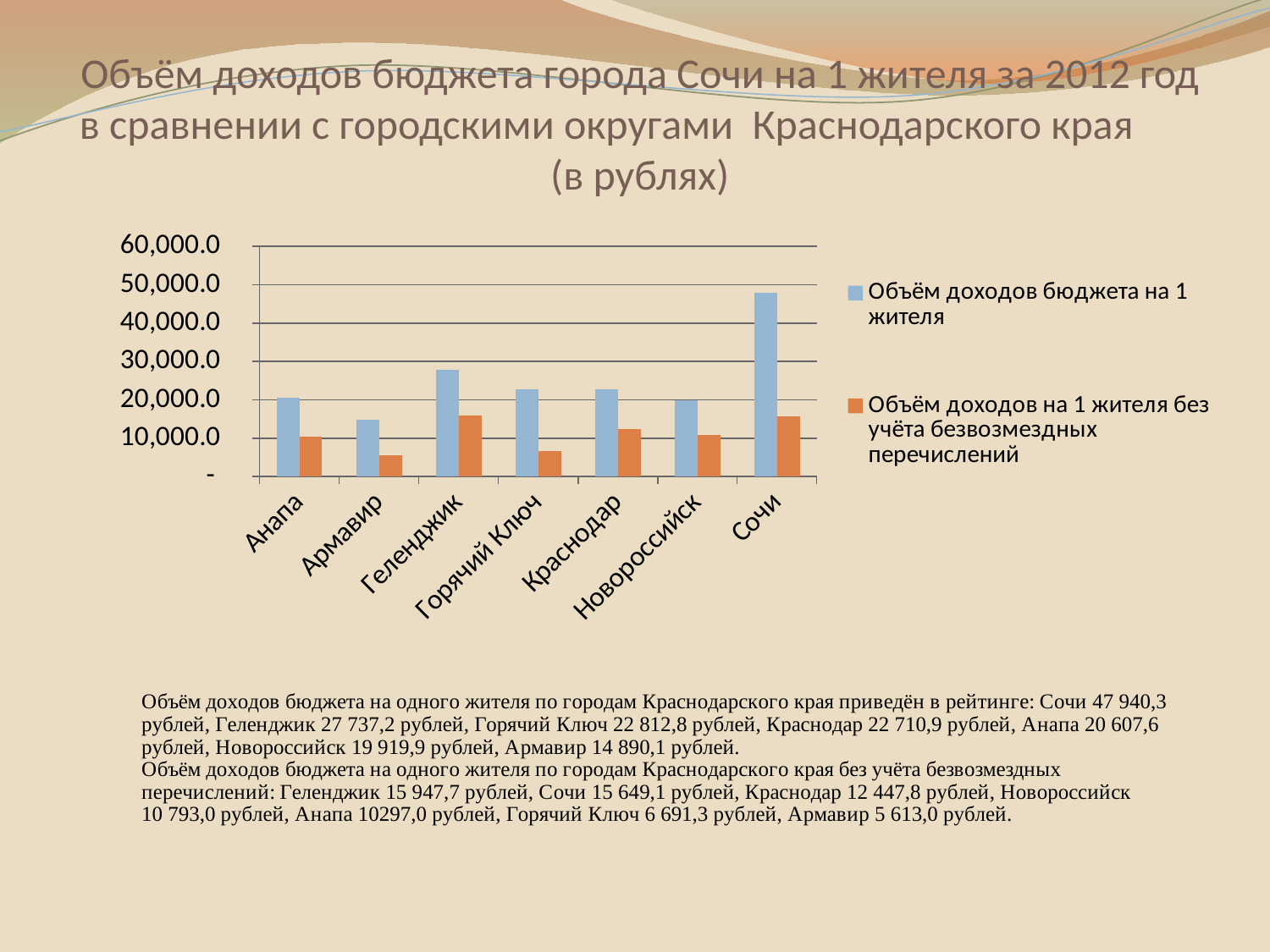
Is the value for Сочи in the series 'Объём доходов бюджета на 1 жителя' greater or less than 40,000.0? greater How many series does the chart legend list? 2 How many cities are shown on the x axis of the chart? 7 According to the slide, what is the income per resident without gratuitous transfers for Геленджик? 15 947,7 рублей What type of chart is shown on the slide? bar chart Which city has the larger value for 'Объём доходов на 1 жителя без учёта безвозмездных перечислений': Новороссийск or Горячий Ключ? Новороссийск What are the two series names listed in the chart legend? Объём доходов бюджета на 1 жителя; Объём доходов на 1 жителя без учёта безвозмездных перечислений Which city has the larger value for 'Объём доходов бюджета на 1 жителя': Геленджик or Краснодар? Геленджик Is the value for Армавир in the series 'Объём доходов на 1 жителя без учёта безвозмездных перечислений' greater or less than 10,000.0? less According to the slide, what is the budget income per resident for Сочи? 47 940,3 рублей Which city has the highest value for 'Объём доходов бюджета на 1 жителя'? Сочи Which city has the lowest value for 'Объём доходов бюджета на 1 жителя'? Армавир